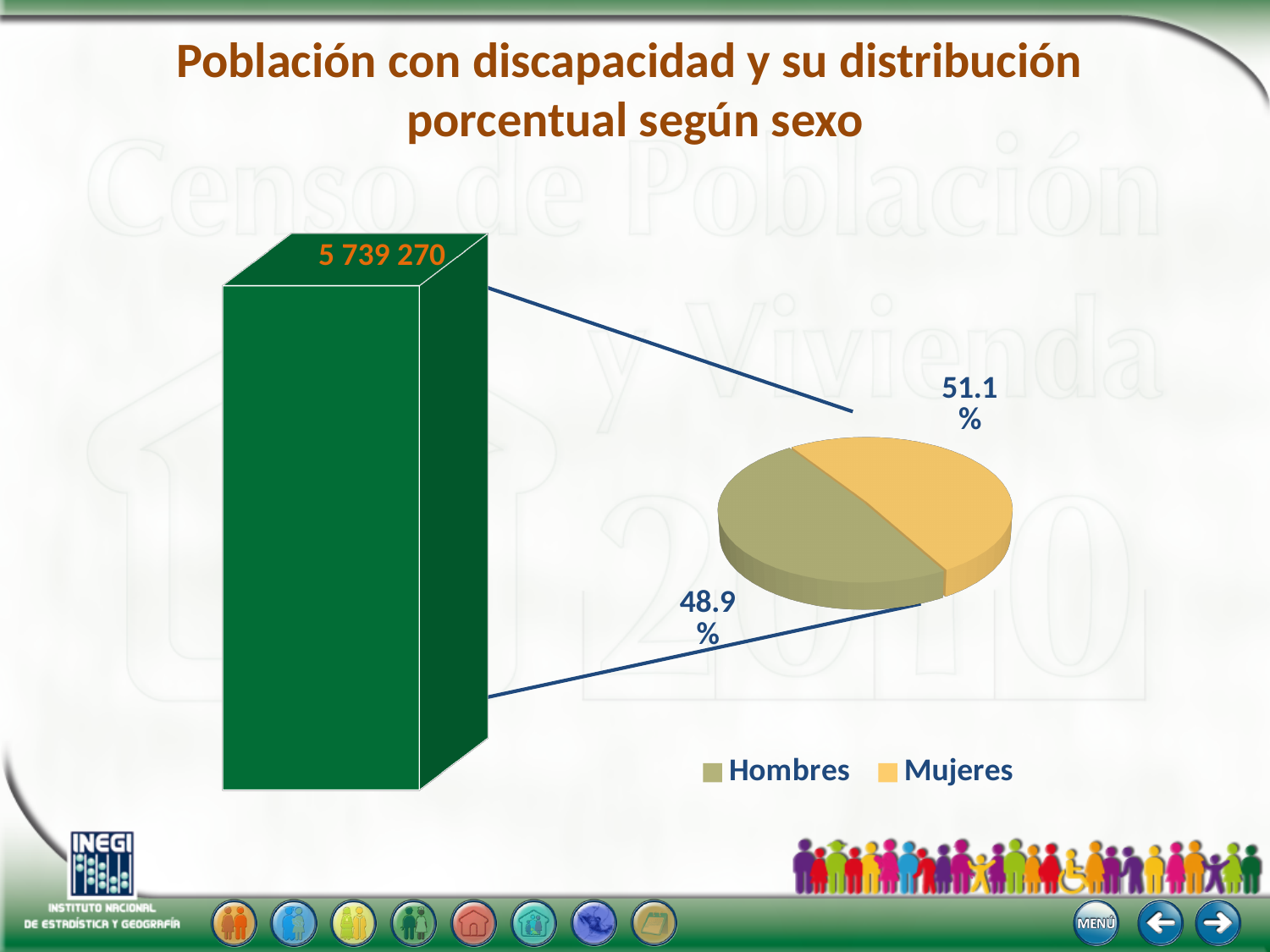
What is the title of the slide? Población con discapacidad y su distribución porcentual según sexo On the pie chart, which colour represents Mujeres? yellow On the pie chart, which slice is larger, Hombres or Mujeres? Mujeres On the pie chart, what share is shown for Hombres? 48.9% On the pie chart, what is the difference in percentage points between Mujeres and Hombres? 2.2 What kind of chart is on the left side of the slide? bar chart How many entries does the pie chart legend list? 2 What kind of chart is on the right side of the slide? pie chart On the pie chart, what share is shown for Mujeres? 51.1% How many slices does the pie chart have? 2 On the bar chart on the left, what value is printed on the bar? 5 739 270 On the pie chart, which category has the smallest share? Hombres